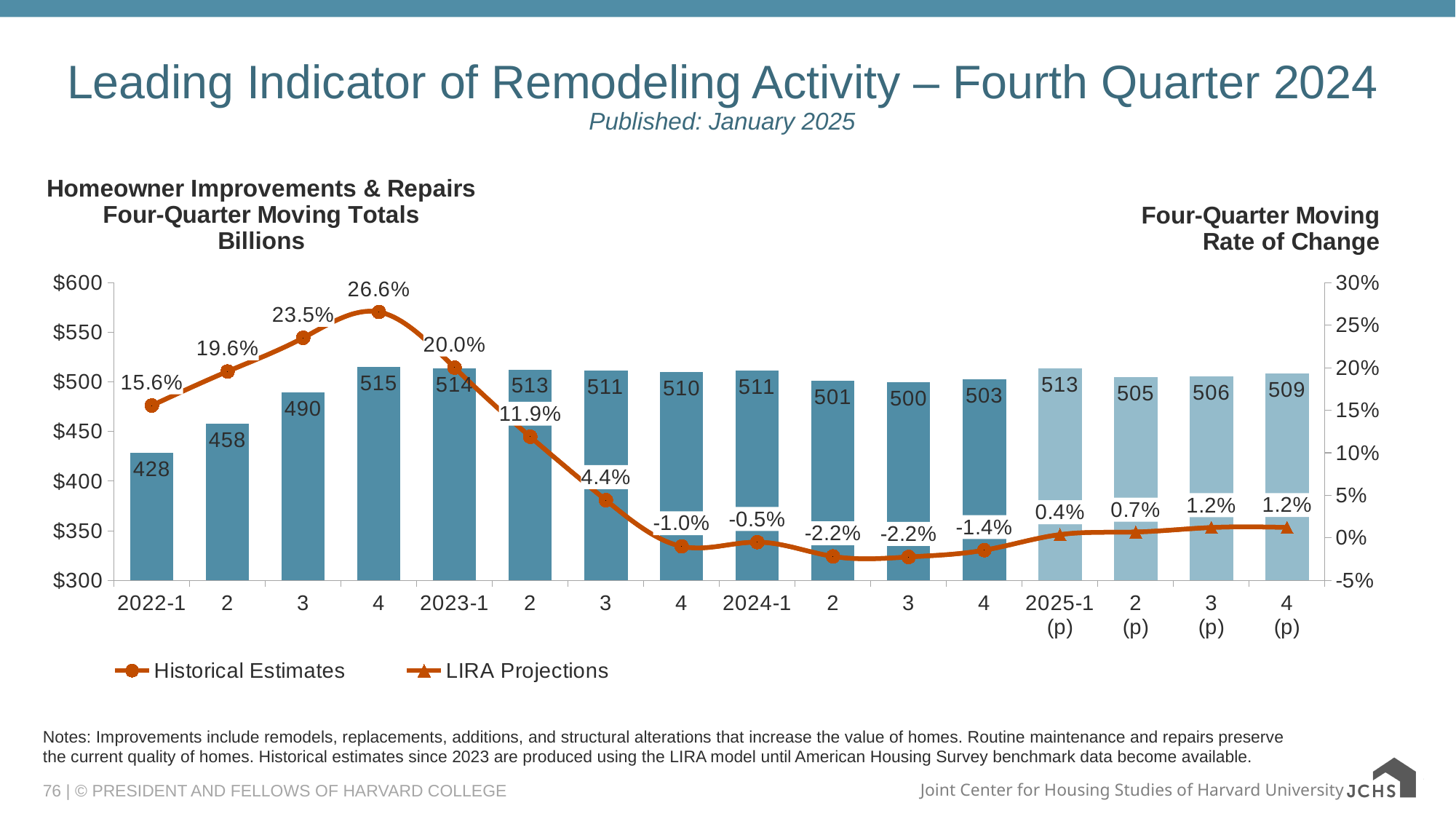
What is the four-quarter moving total (in billions) for 2022-1? 428 What is the four-quarter moving rate of change for 2022-4? 26.6% How many quarters are shown on the x axis? 16 Does the four-quarter moving rate of change rise or fall from 2022-4 to 2024-2? fall What is the projected four-quarter moving total for 2025-4 (p)? 509 Which quarter has the lowest four-quarter moving total? 2022-1 What are the two series named in the legend? Historical Estimates and LIRA Projections Which is larger, the four-quarter moving total for 2024-2 or for 2025-1 (p)? 2025-1 (p) Which quarter has the highest four-quarter moving rate of change? 2022-4 Is the four-quarter moving rate of change for 2023-2 greater or less than 10%? greater What is the difference between the four-quarter moving totals for 2022-4 and 2022-1? 87 How many series does the legend list? 2